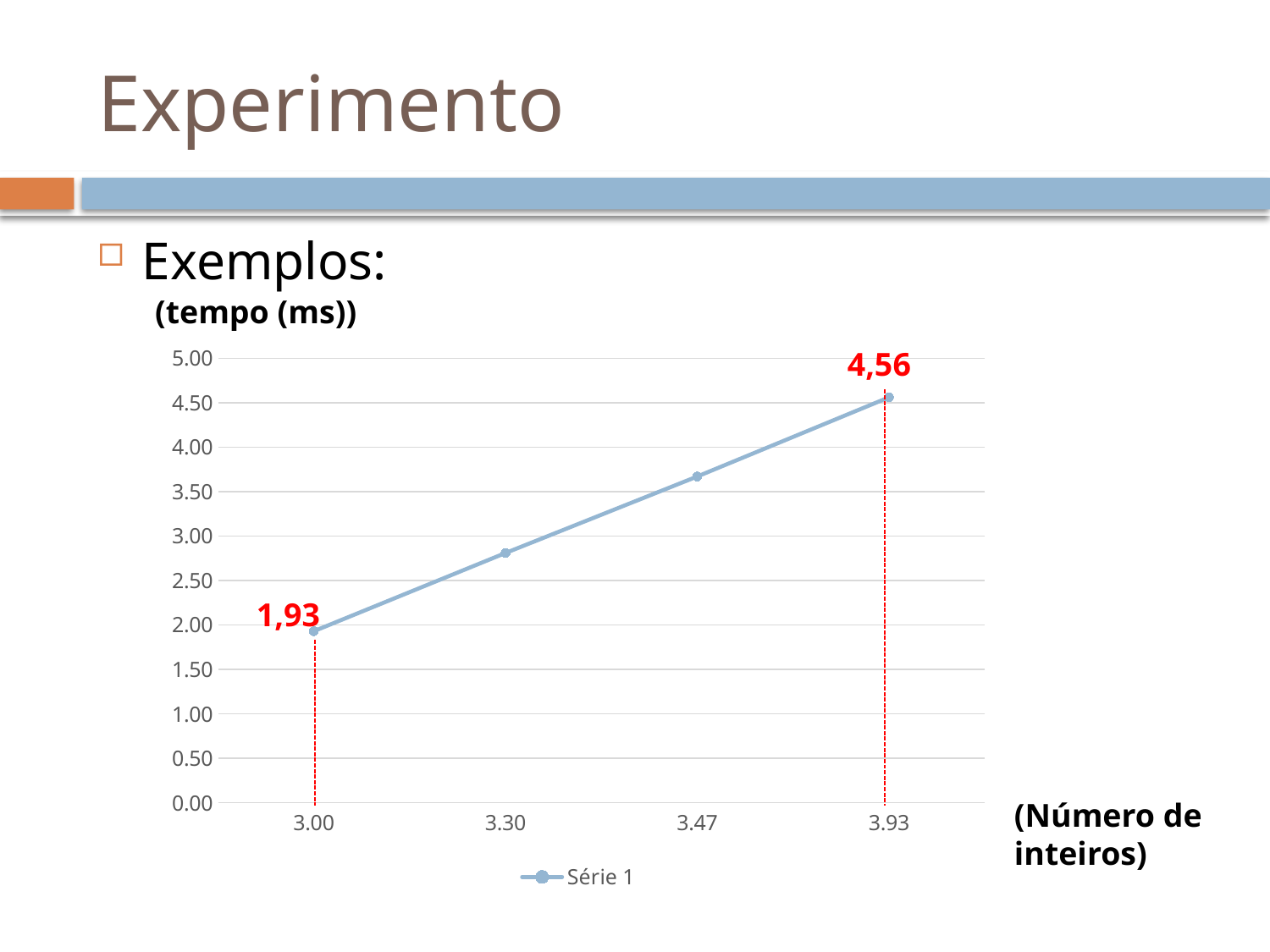
Is the value for x = 3.30 greater or less than 3.00? less What is the difference between the value at 3.93 and the value at 3.00? 2,63 What is the value plotted at x = 3.00? 1,93 Which has the larger plotted value, x = 3.00 or x = 3.93? 3.93 At which x-axis category is the plotted value lowest? 3.00 What kind of chart is shown on the slide? line chart At which x-axis category is the plotted value highest? 3.93 How many series does the legend list? 1 Do the plotted values rise or fall as you move along the x axis from 3.00 to 3.93? rise How many data points are plotted on the chart? 4 What is the value plotted at x = 3.93? 4,56 Is the value for x = 3.47 greater or less than 4.00? less